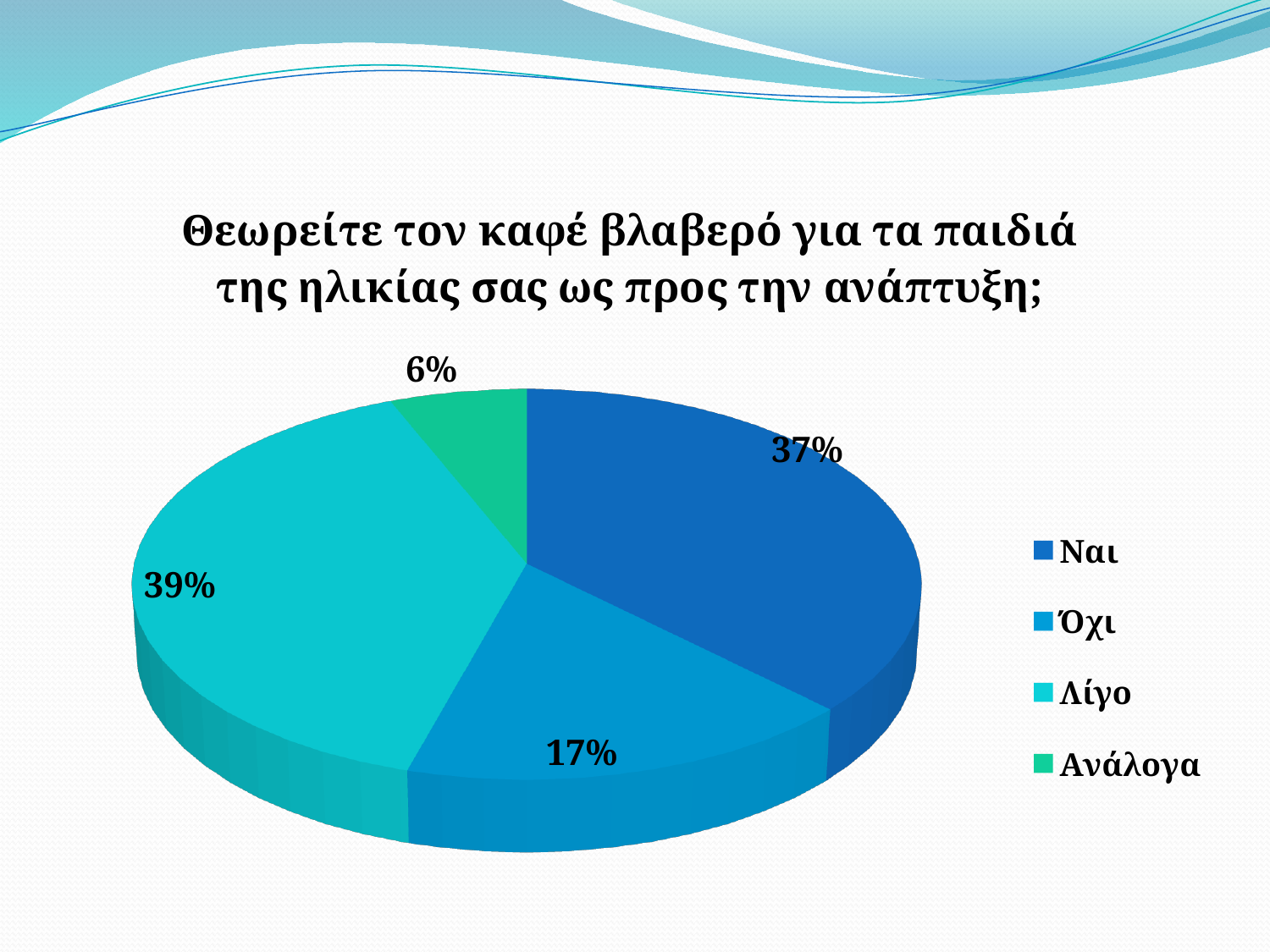
Which answer has the smallest share of the pie? Ανάλογα How many slices does the pie chart have? 4 Which is larger, the share for Ναι or the share for Όχι? Ναι What is the title of the chart? Θεωρείτε τον καφέ βλαβερό για τα παιδιά της ηλικίας σας ως προς την ανάπτυξη; What percentage of respondents answered Ανάλογα? 6% What percentage of respondents answered Λίγο? 39% What percentage of respondents answered Όχι? 17% How many entries does the legend list? 4 What kind of chart is shown on the slide? pie chart What is the difference in percentage points between Ναι and Όχι? 20 What percentage of respondents answered Ναι? 37% Which answer has the largest share of the pie? Λίγο